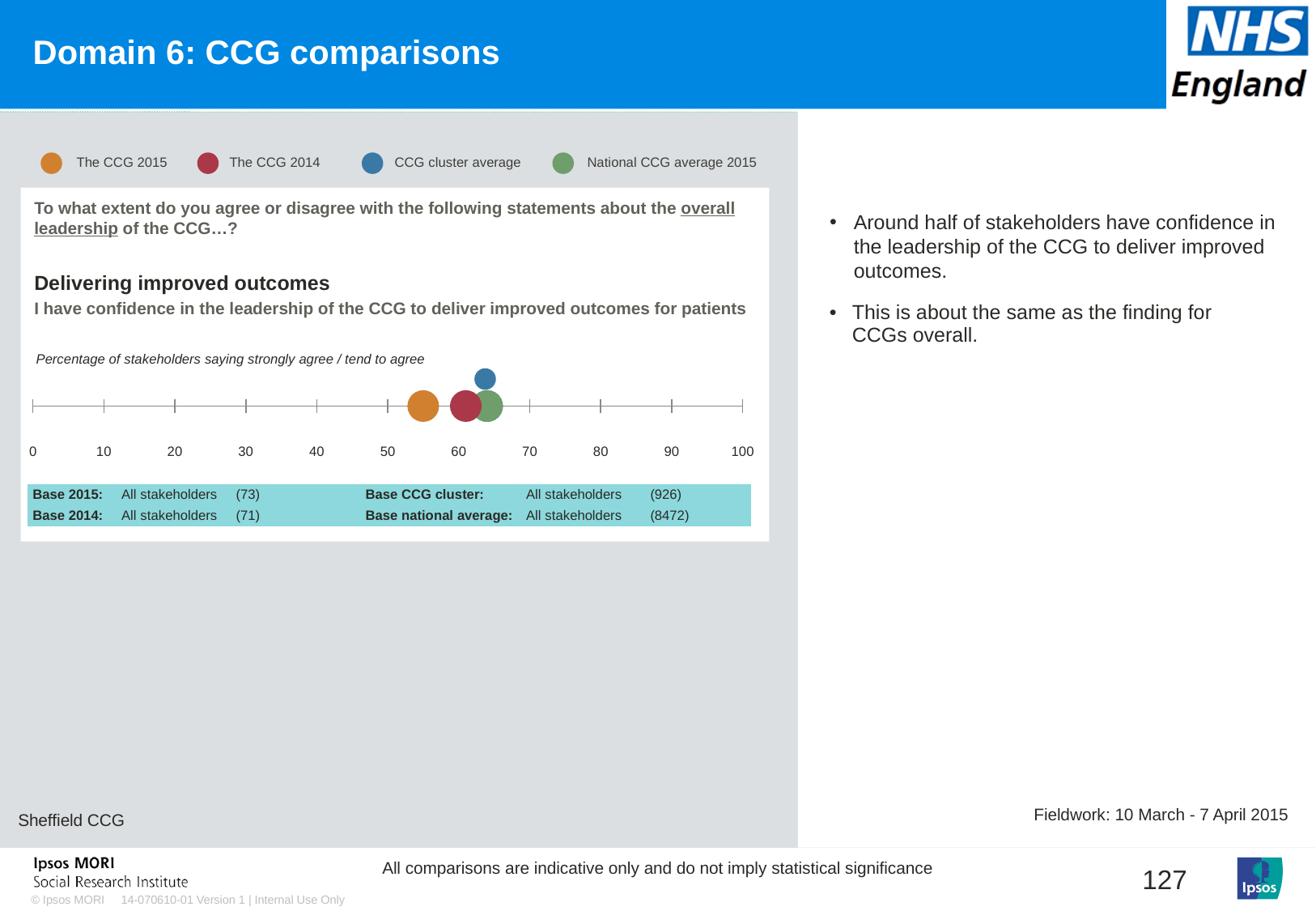
Is the value for The CCG 2015 greater or less than 60? less Is the value for the CCG cluster average greater or less than 60? greater What kind of chart is shown on the slide? Dot plot What is the maximum value shown on the chart's axis? 100 Is the value for the National CCG average 2015 greater or less than 70? less Which series has the lowest value on the chart? The CCG 2015 Which is larger, the value for The CCG 2015 or the National CCG average 2015? National CCG average 2015 How many series does the legend list? 4 What colour is used for The CCG 2015 in the legend? Orange Which is larger, the value for The CCG 2015 or The CCG 2014? The CCG 2014